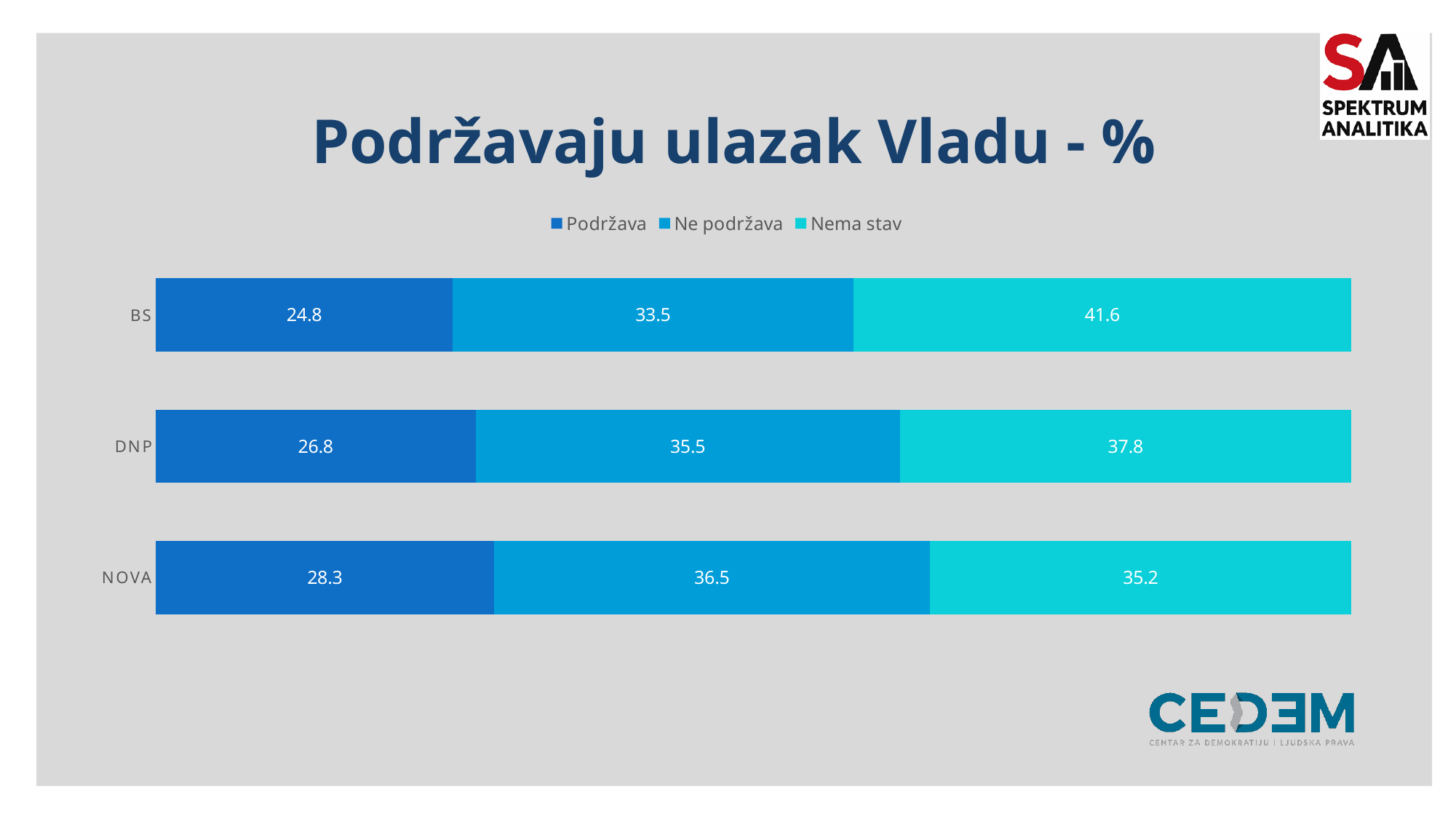
Which category has the highest 'Podržava' value? NOVA How many series does the legend list? 3 Which category has the lowest 'Nema stav' value? NOVA What kind of chart is shown on the slide? Stacked bar chart What is the 'Ne podržava' value for DNP? 35.5 Which is larger: the 'Ne podržava' value for NOVA or for BS? NOVA What is the 'Podržava' value for BS? 24.8 How many categories are shown on the chart? 3 What is the total of the stacked bar for DNP? 100.1 What is the title of the chart? Podržavaju ulazak Vladu - % What is the 'Nema stav' value for NOVA? 35.2 What is the difference between the 'Nema stav' values for BS and DNP? 3.8